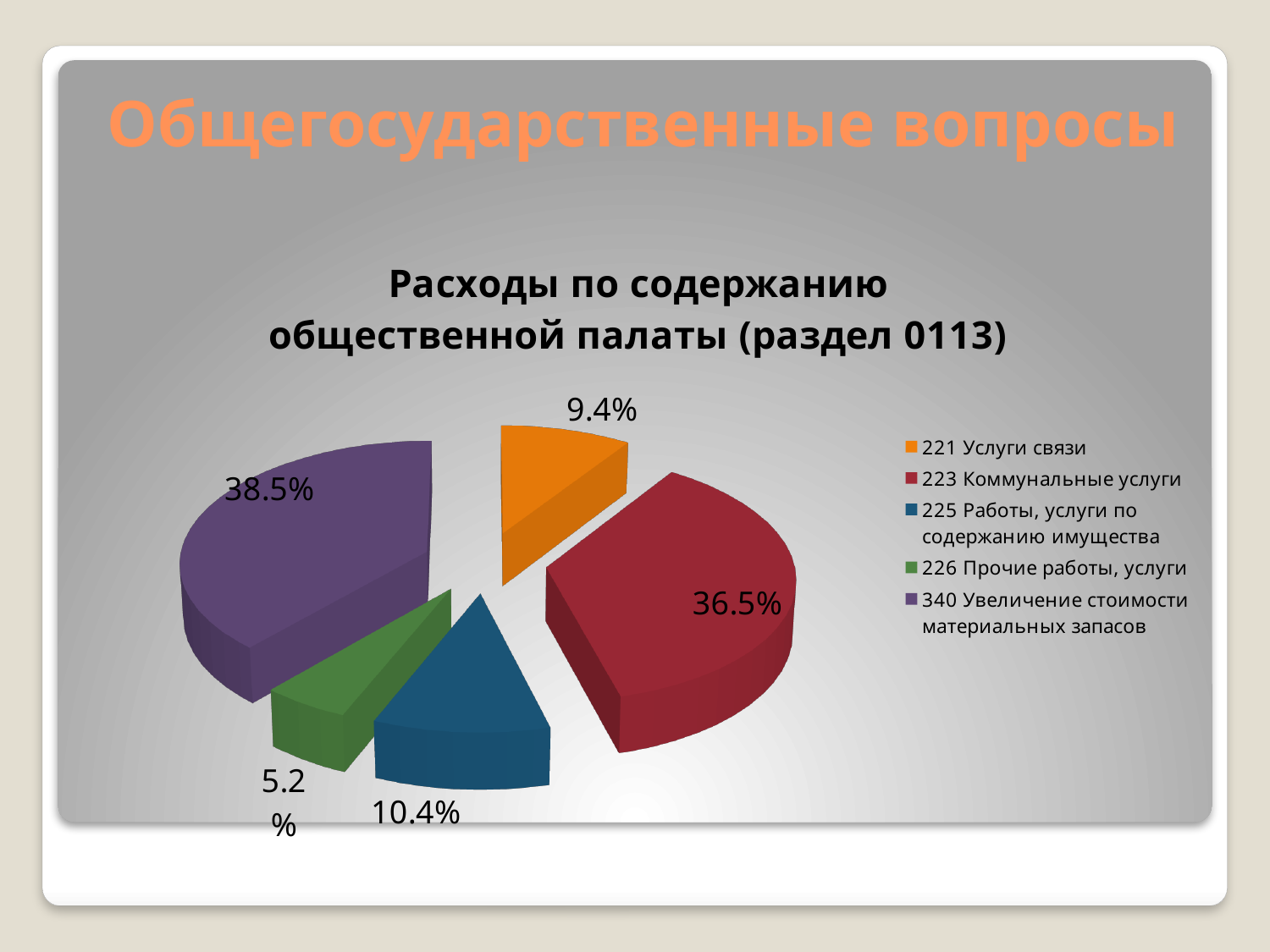
What is the difference between the shares of "340 Увеличение стоимости материальных запасов" and "223 Коммунальные услуги"? 2.0% What share of the pie does "225 Работы, услуги по содержанию имущества" have? 10.4% Which is larger: the share of "225 Работы, услуги по содержанию имущества" or the share of "221 Услуги связи"? 225 Работы, услуги по содержанию имущества What share of the pie does "221 Услуги связи" have? 9.4% What is the title of the chart? Расходы по содержанию общественной палаты (раздел 0113) How many categories does the pie chart have? 5 Which category has the largest share of the pie? 340 Увеличение стоимости материальных запасов Which category has the smallest share of the pie? 226 Прочие работы, услуги What share of the pie does "223 Коммунальные услуги" have? 36.5% What type of chart is shown on the slide? Pie chart